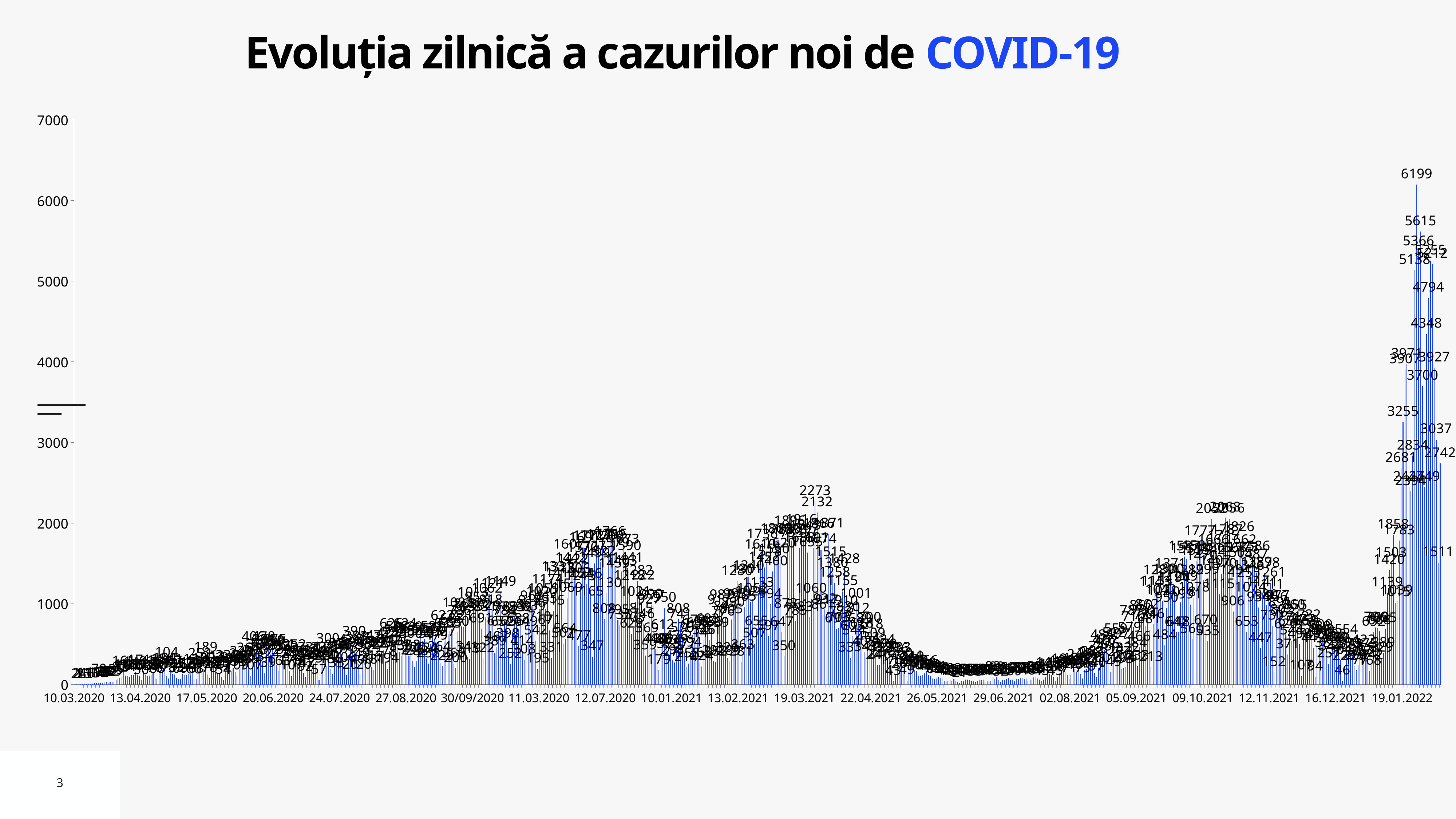
What is the first date label shown on the horizontal axis? 10.03.2020 What kind of chart is shown on the slide? bar chart Which period has the higher peak: around 19.03.2021 or around 19.01.2022? around 19.01.2022 Between 02.08.2021 and 09.10.2021, do the daily values rise or fall? rise What is the difference between the two highest labelled values, 6199 and 5615? 584 Are the daily values around 29.06.2021 greater or less than 1000? less What is the highest daily value labelled on the chart? 6199 What is the title of the chart? Evoluția zilnică a cazurilor noi de COVID-19 What is the highest tick value shown on the vertical axis? 7000 Is the highest value on the chart greater or less than 6000? greater What is the highest value labelled in the wave around 19.03.2021? 2273